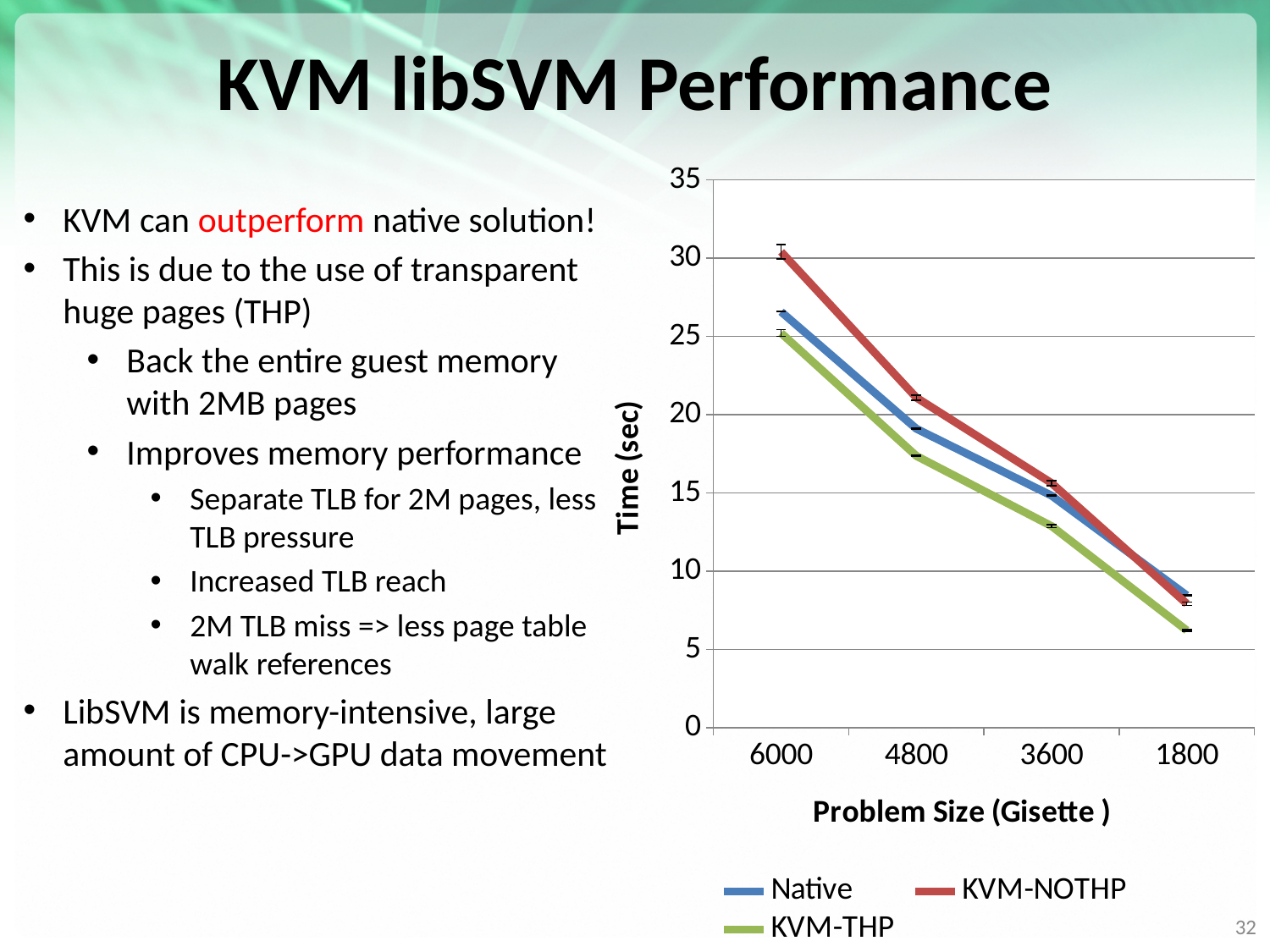
Is the value for KVM-THP at problem size 1800 greater or less than 10? less Is the value for KVM-THP at problem size 4800 greater or less than 20? less Is the value for KVM-NOTHP at problem size 6000 greater or less than 25? greater At problem size 6000, which is larger: the value for Native or the value for KVM-THP? Native How many series does the legend list? 3 What kind of chart is shown on the slide? line chart What is the title of the y axis? Time (sec) Which series has the highest value at problem size 6000? KVM-NOTHP How many problem sizes are plotted along the x axis? 4 Which series has the lowest value at problem size 3600? KVM-THP Do the values for KVM-NOTHP rise or fall moving along the x axis from 6000 to 1800? fall